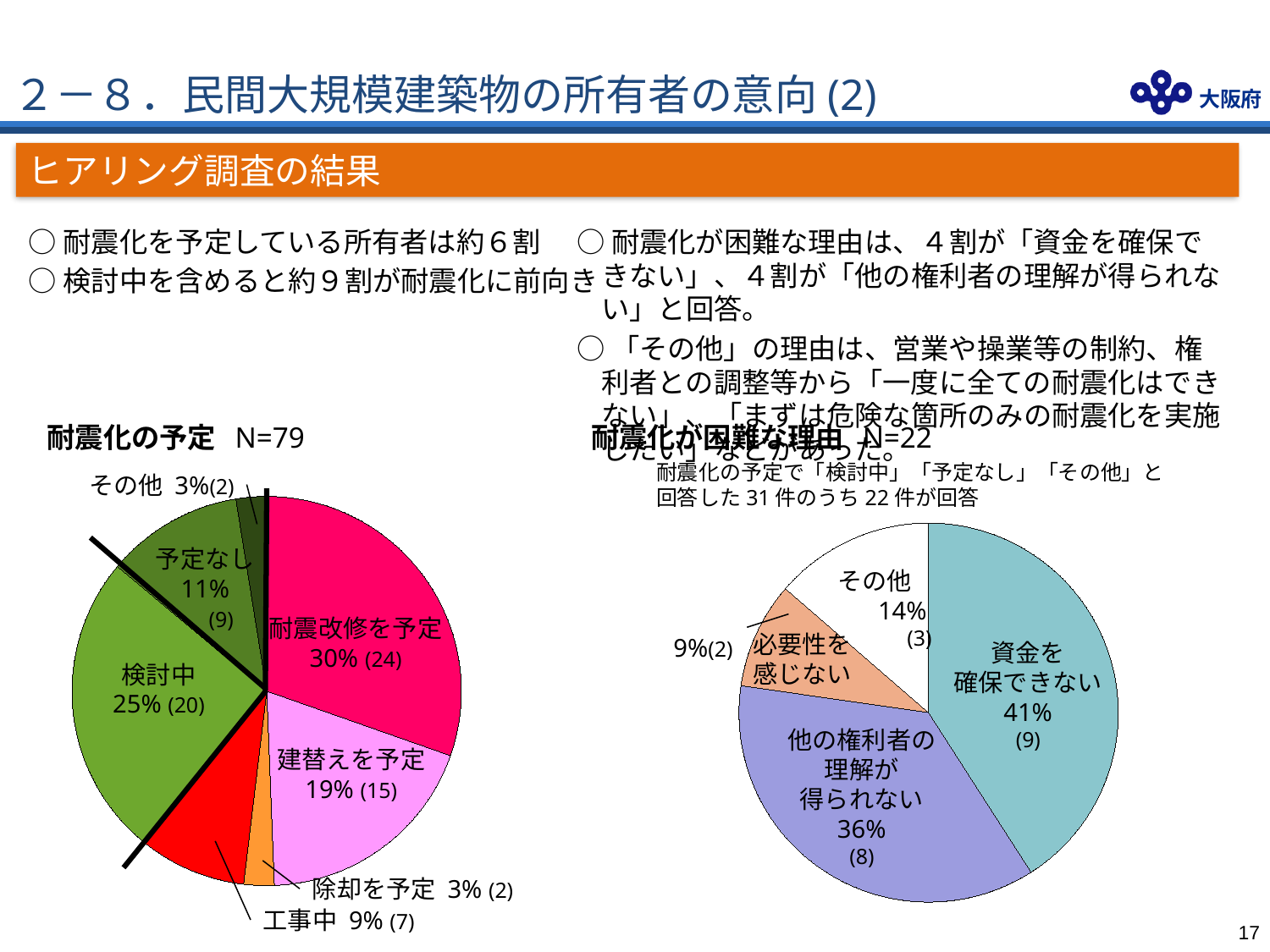
What type of chart is used for 耐震化が困難な理由? Pie chart In the 耐震化が困難な理由 pie chart, how many categories are shown? 4 In the 耐震化が困難な理由 pie chart, which category has the smallest share? 必要性を感じない In the 耐震化の予定 pie chart, which is larger: 予定なし or 除却を予定? 予定なし In the 耐震化の予定 pie chart, how many categories are shown? 7 In the 耐震化の予定 pie chart, what percentage is shown for 耐震改修を予定? 30% In the 耐震化の予定 pie chart, how many respondents (count in parentheses) chose 検討中? 20 In the 耐震化の予定 pie chart, what is the difference in percentage points between 建替えを予定 and 工事中? 10 In the 耐震化が困難な理由 pie chart, how many respondents chose 他の権利者の理解が得られない? 8 What is the N value shown for the 耐震化の予定 chart? N=79 In the 耐震化が困難な理由 pie chart, what percentage is shown for 資金を確保できない? 41% In the 耐震化の予定 pie chart, which category has the largest share? 耐震改修を予定